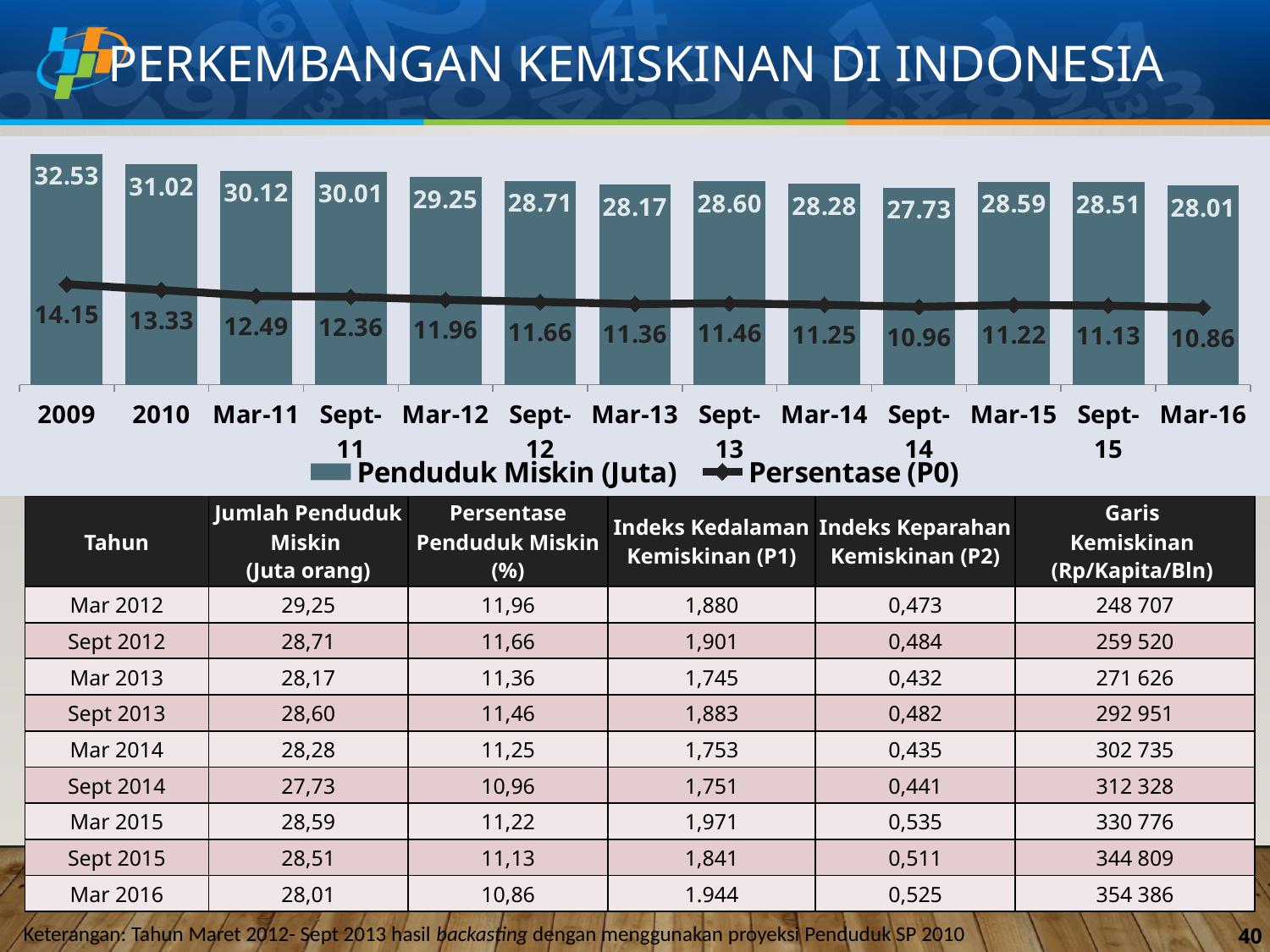
What is the Persentase (P0) value for Mar-16? 10.86 Which is larger, the Penduduk Miskin (Juta) value for Mar-15 or for Sept-15? Mar-15 How many categories are shown on the x axis of the chart? 13 What is the overall trend of the Persentase (P0) line from 2009 to Mar-16? Falling What is the Penduduk Miskin (Juta) value for Sept-14? 27.73 How many series does the chart legend list? 2 Which category has the lowest Penduduk Miskin (Juta) value? Sept-14 What is the value of Penduduk Miskin (Juta) for 2009? 32.53 What is the difference between the Penduduk Miskin (Juta) values for 2009 and 2010? 1.51 Which category has the highest Persentase (P0) value? 2009 What is the difference between the Persentase (P0) values for Mar-13 and Sept-13? 0.10 What are the two series named in the chart legend? Penduduk Miskin (Juta) and Persentase (P0)